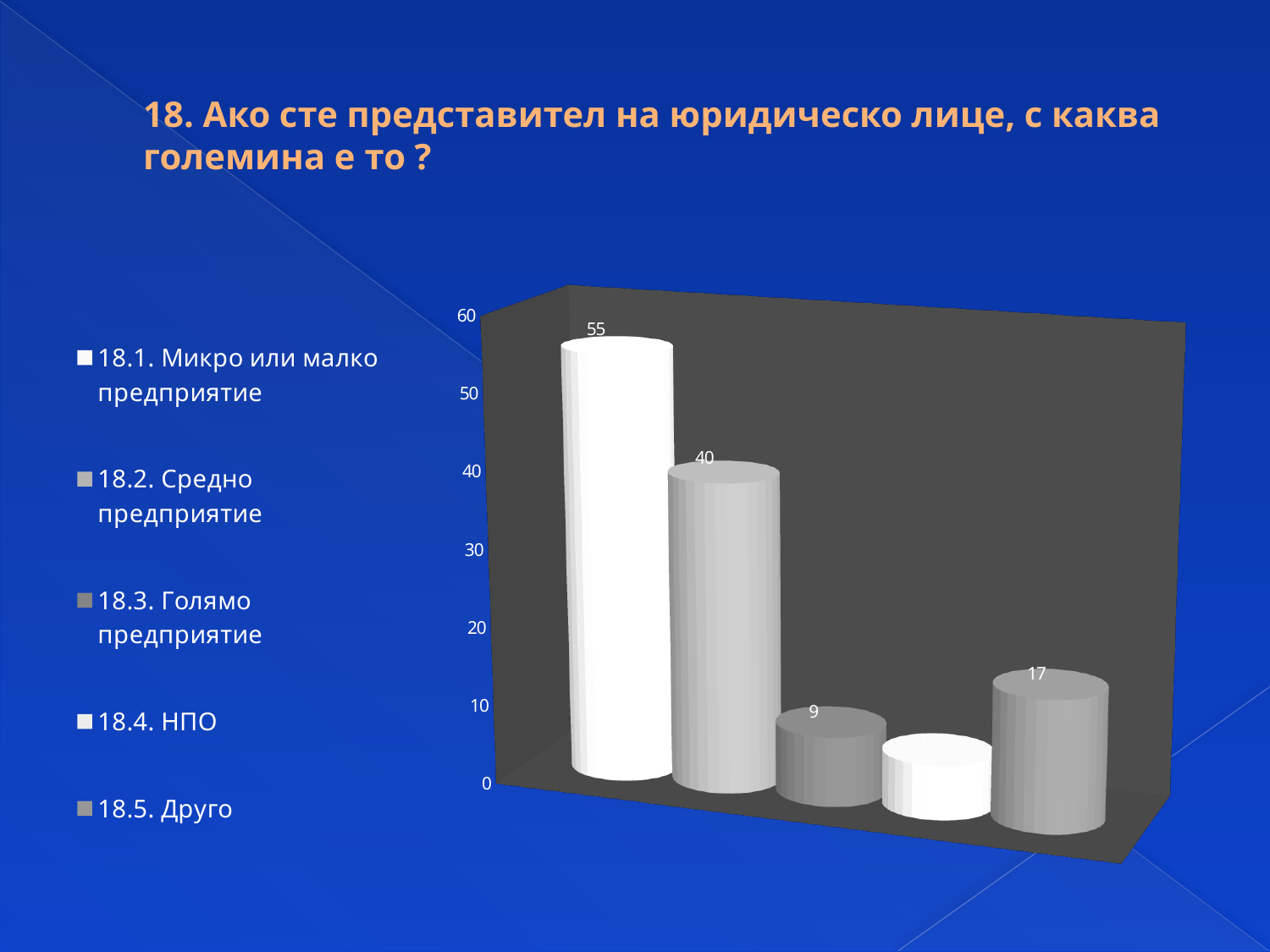
Which category has the highest value? 18.1. Микро или малко предприятие What is the value for 18.3. Голямо предприятие? 9 What kind of chart is shown on the slide? bar chart How many categories are shown in the chart? 5 Which category has the lowest value? 18.4. НПО Is the value for 18.4. НПО greater or less than 10? less Which is larger, the value for 18.3. Голямо предприятие or the value for 18.5. Друго? 18.5. Друго What is the difference between the values for 18.1. Микро или малко предприятие and 18.2. Средно предприятие? 15 What is the value for 18.1. Микро или малко предприятие? 55 What is the value for 18.2. Средно предприятие? 40 What is the value for 18.5. Друго? 17 What is the highest value shown on the vertical axis? 60